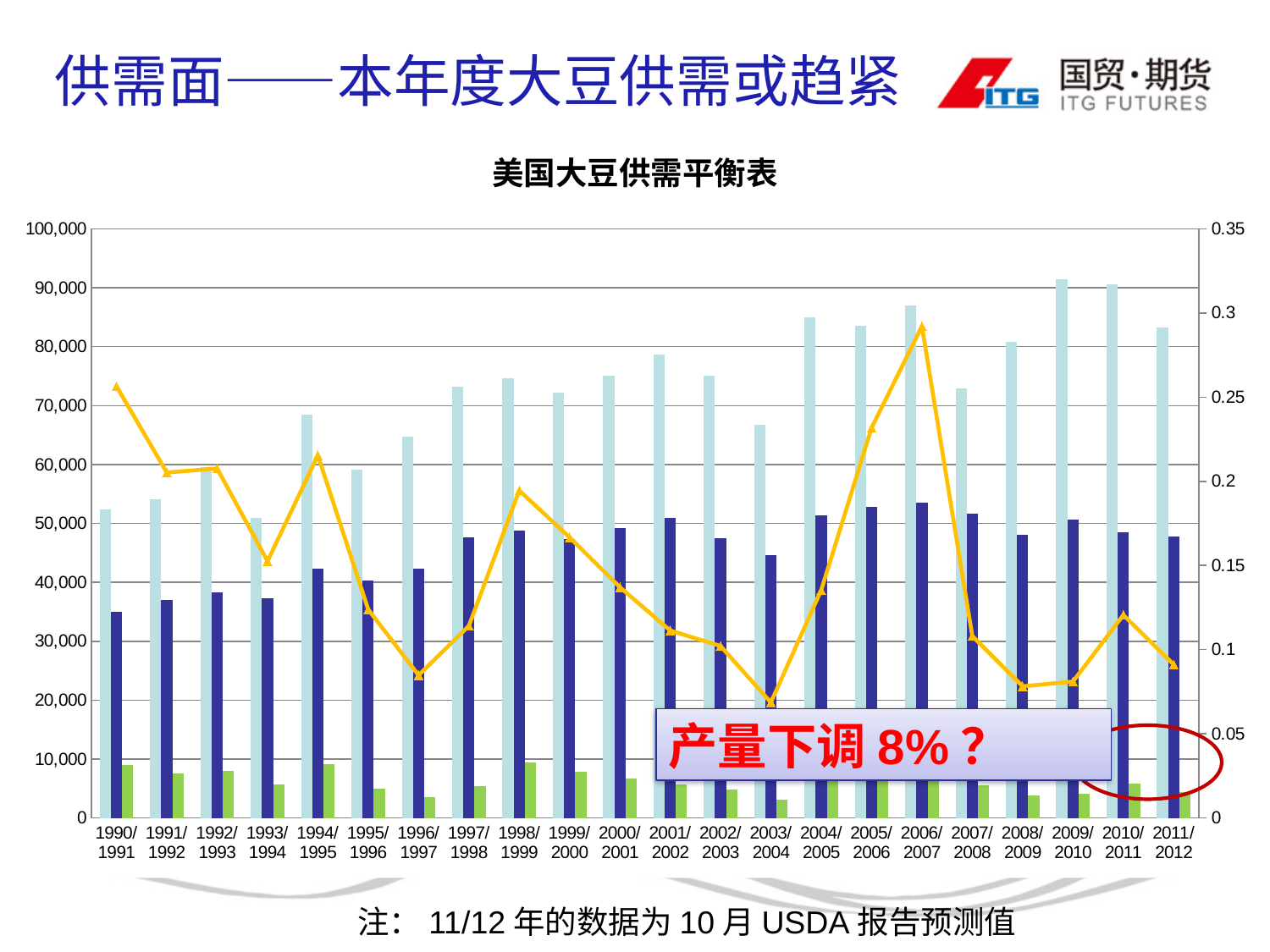
Is the orange line value for 2003/2004 greater or less than 0.1 on the right axis? less What is the title of the chart? 美国大豆供需平衡表 Is the light blue bar for 2009/2010 greater or less than 90,000? greater Does the orange line rise or fall from 1990/1991 to 1993/1994? fall Which year has the taller light blue bar, 2003/2004 or 2004/2005? 2004/2005 How many marketing-year categories are shown on the x axis? 22 In which year does the orange line reach its highest point? 2006/2007 Which year has the lowest dark blue bar? 1990/1991 Which year has the lowest green bar? 2003/2004 In which year does the orange line reach its lowest point? 2003/2004 Is the dark blue bar for 1990/1991 greater or less than 40,000? less What kind of chart is shown on the slide? Combined bar and line chart